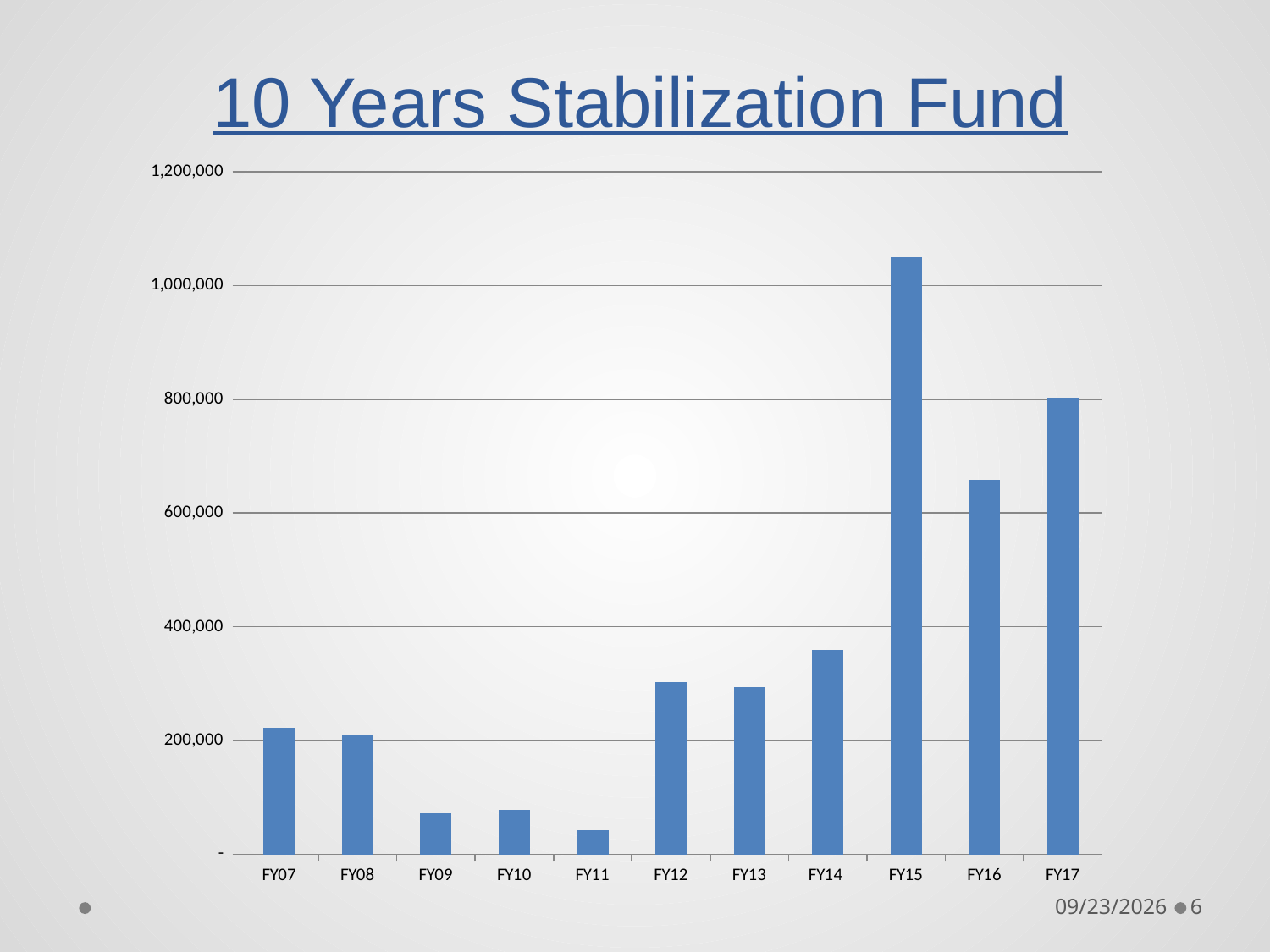
What is the title of the chart? 10 Years Stabilization Fund Which fiscal year has the highest value? FY15 From FY11 to FY15, do the values rise or fall? rise Which fiscal year has the lowest value? FY11 Is the value for FY14 greater or less than 400,000? less Is the value for FY15 greater or less than 1,000,000? greater Is the value for FY11 greater or less than 200,000? less Which is larger, the value for FY07 or the value for FY09? FY07 How many fiscal years are plotted on the x axis? 11 Which is larger, the value for FY16 or the value for FY17? FY17 What kind of chart is shown on the slide? bar chart